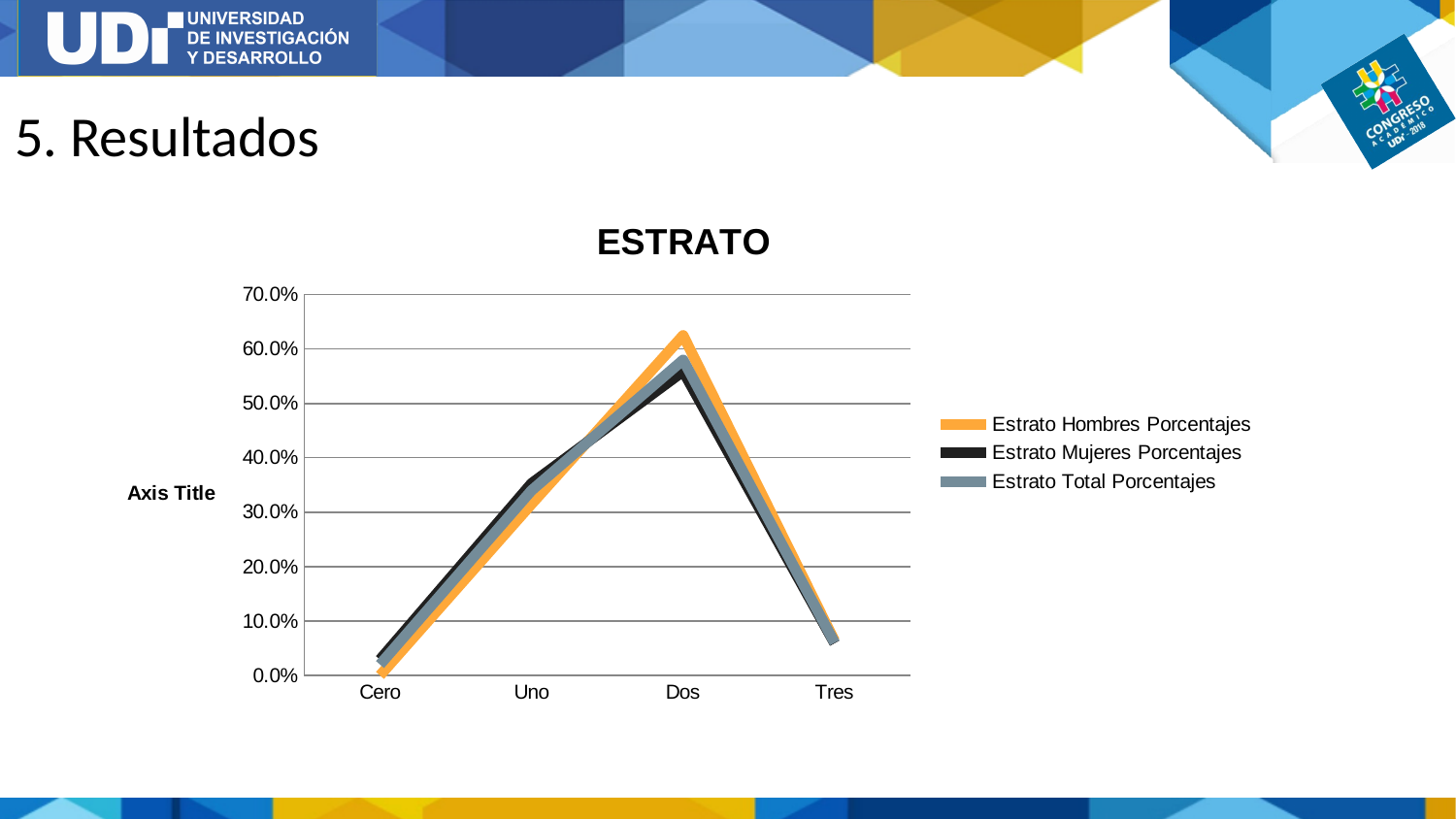
Which category has the highest value for Estrato Hombres Porcentajes? Dos How many categories are shown on the x axis? 4 Is the value for Estrato Hombres Porcentajes at Dos greater or less than 60.0%? greater At Dos, which series has the larger value: Estrato Hombres Porcentajes or Estrato Mujeres Porcentajes? Estrato Hombres Porcentajes What is the title of the chart? ESTRATO Do the values for Estrato Total Porcentajes rise or fall from Dos to Tres? fall Is the value for Estrato Total Porcentajes at Tres greater or less than 10.0%? less What kind of chart is shown on the slide? Line chart Is the value for Estrato Mujeres Porcentajes at Dos greater or less than 60.0%? less Which category has the lowest value for Estrato Hombres Porcentajes? Cero How many series does the legend list? 3 Which series is drawn in orange? Estrato Hombres Porcentajes